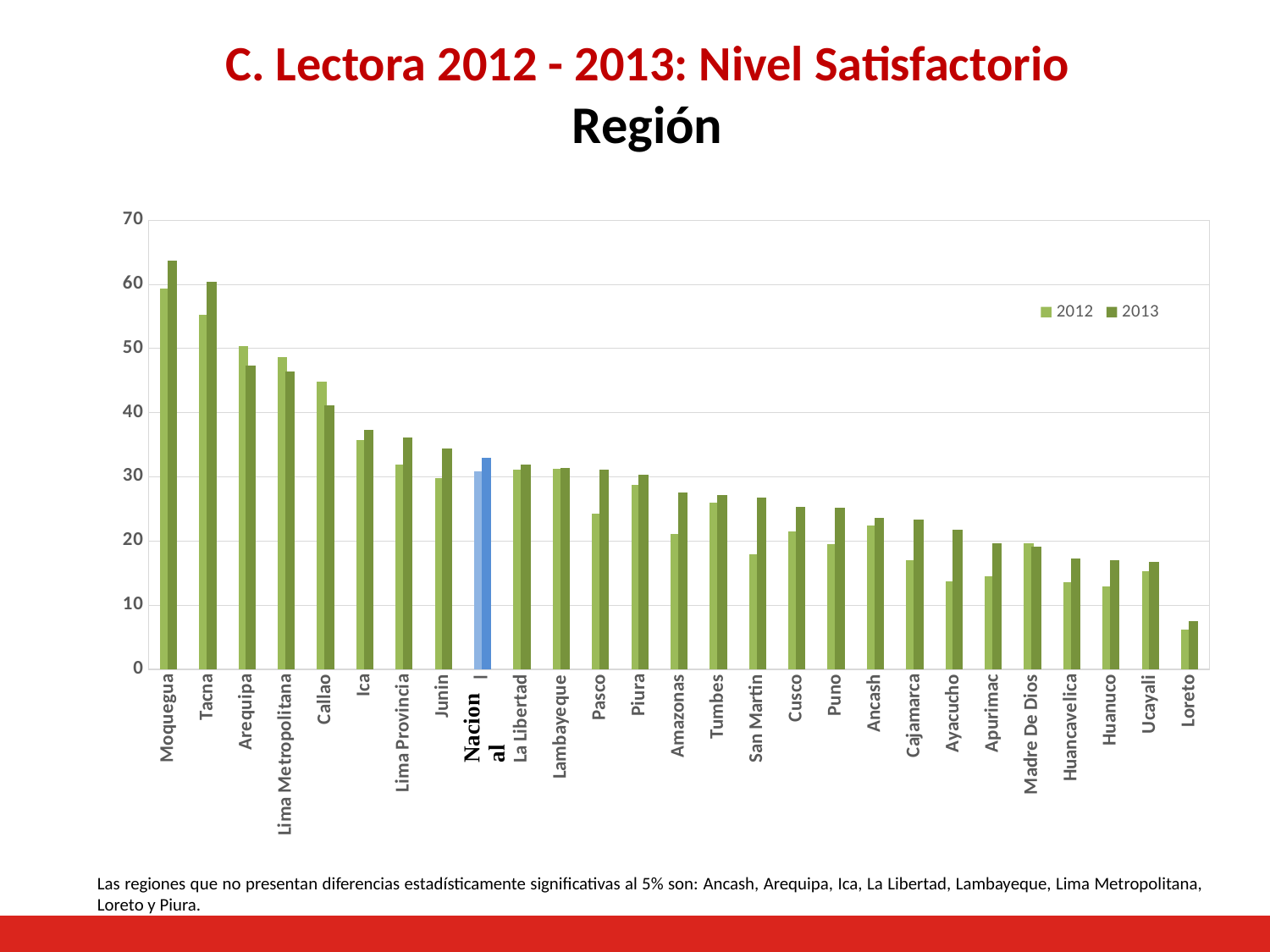
How many categories are shown along the x axis? 27 Which category has the lowest 2012 value? Loreto Is the 2012 value for Moquegua greater or less than 50? greater Is the 2013 value for Loreto greater or less than 10? less Which category has the highest 2013 value? Moquegua For Pasco, which is larger: the 2012 value or the 2013 value? 2013 Is the 2013 value for Ica greater or less than 30? greater What kind of chart is shown on the slide? bar chart For Arequipa, which is larger: the 2012 value or the 2013 value? 2012 Do the values generally rise or fall moving from left to right along the x axis? fall How many series does the legend list? 2